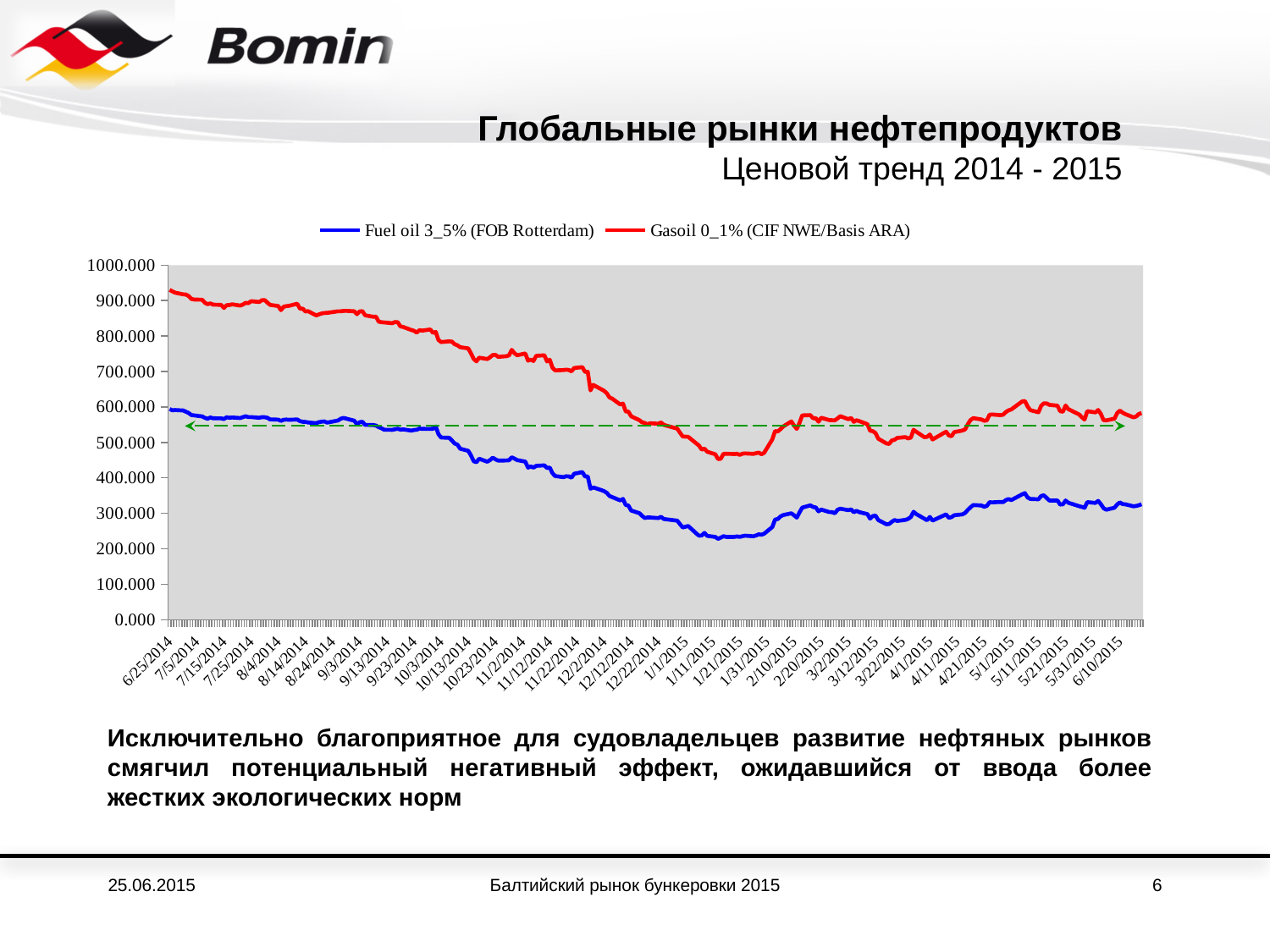
Which series has the higher value on 6/25/2014, Fuel oil 3_5% (FOB Rotterdam) or Gasoil 0_1% (CIF NWE/Basis ARA)? Gasoil 0_1% (CIF NWE/Basis ARA) Is the value for Gasoil 0_1% (CIF NWE/Basis ARA) on 1/11/2015 greater or less than 500? less Does the Gasoil 0_1% (CIF NWE/Basis ARA) series rise or fall between 6/25/2014 and 1/11/2015? Fall Is the value for Gasoil 0_1% (CIF NWE/Basis ARA) on 6/25/2014 greater or less than 800? greater Which series is drawn in red? Gasoil 0_1% (CIF NWE/Basis ARA) How many series does the chart legend list? 2 What kind of chart is shown on the slide? Line chart Which series has the lower value on 1/11/2015, Fuel oil 3_5% (FOB Rotterdam) or Gasoil 0_1% (CIF NWE/Basis ARA)? Fuel oil 3_5% (FOB Rotterdam) Does the Fuel oil 3_5% (FOB Rotterdam) series rise or fall between 1/21/2015 and 5/1/2015? Rise Is the value for Fuel oil 3_5% (FOB Rotterdam) on 6/25/2014 greater or less than 500? greater Which series is drawn in blue? Fuel oil 3_5% (FOB Rotterdam)